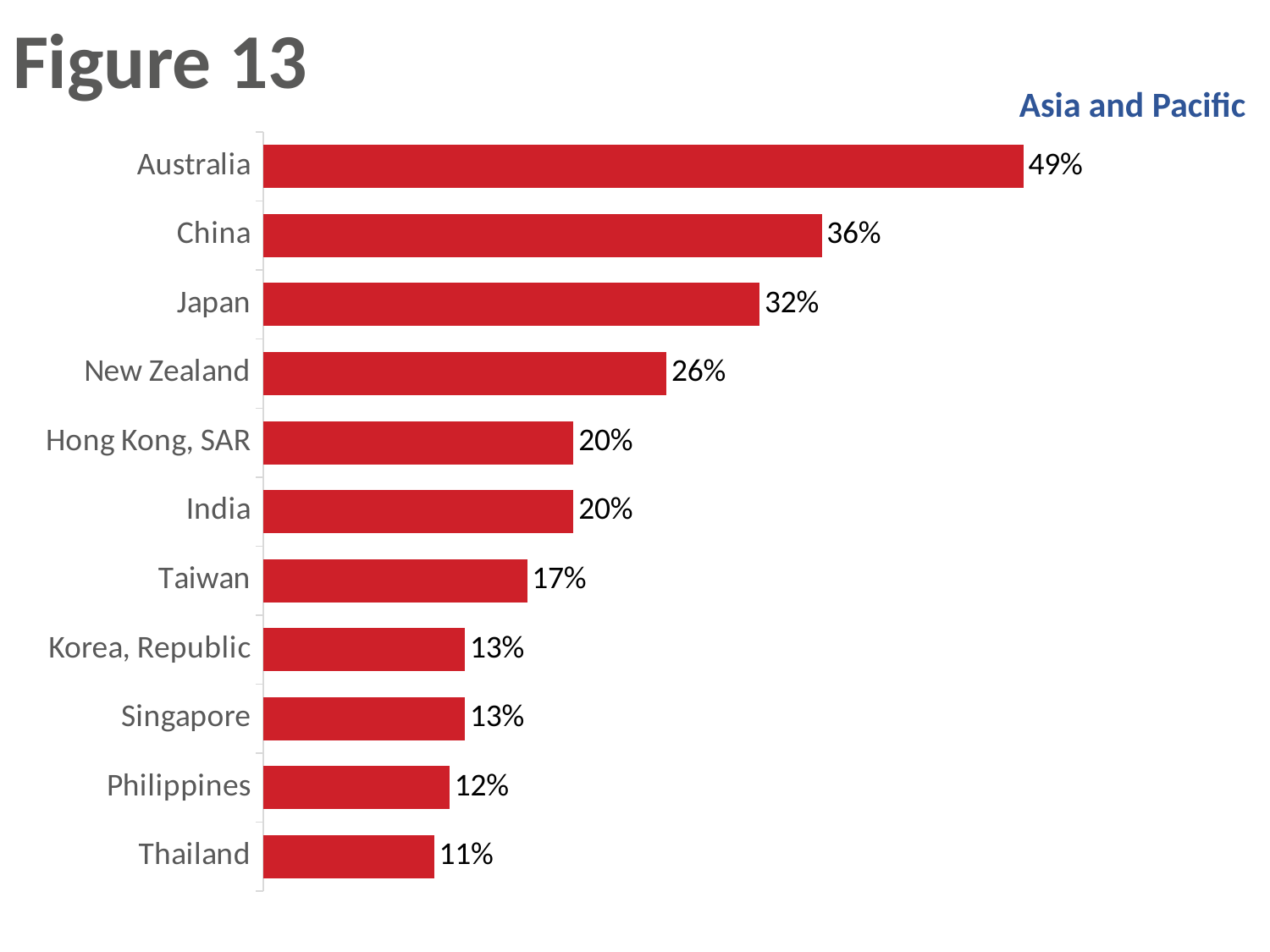
What is the value for Australia? 49% Which country has the highest value? Australia What is the title shown above the chart on the right? Asia and Pacific How many countries or regions are shown in the chart? 11 What is the value for Taiwan? 17% Which is larger, the value for China or the value for Japan? China Which country has the lowest value? Thailand What is the difference between the values for New Zealand and Thailand? 15% What type of chart is shown on the slide? Bar chart What is the difference between the values for Australia and China? 13% What is the value for Japan? 32% What is the value for Philippines? 12%